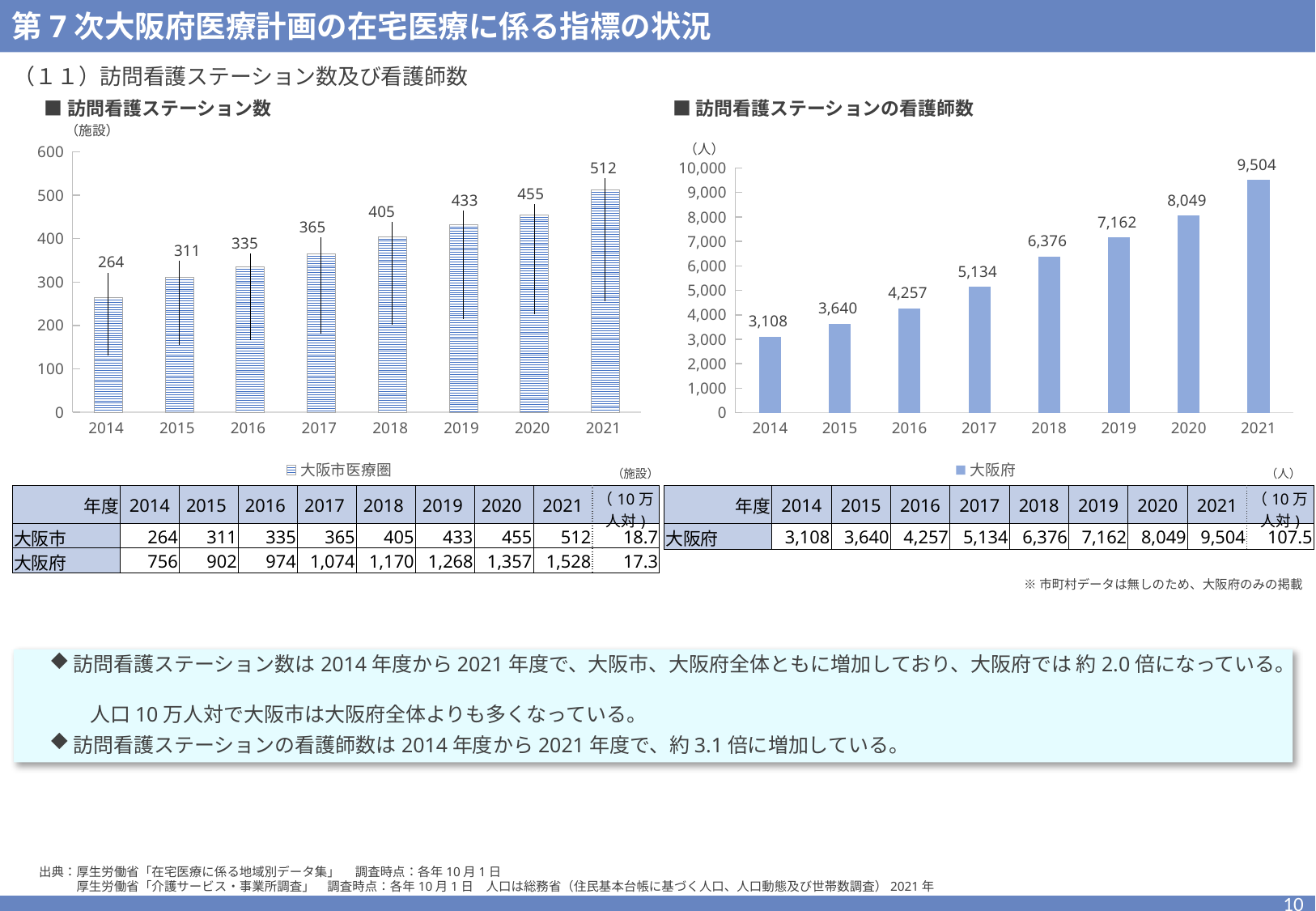
In the 訪問看護ステーション数 chart, how many years are plotted? 8 What kind of chart is the 訪問看護ステーションの看護師数 chart? bar chart In the 訪問看護ステーション数 chart, do the values rise or fall from 2014 to 2021? rise In the 訪問看護ステーションの看護師数 chart, which year has the lowest value? 2014 In the 訪問看護ステーションの看護師数 chart, what is the value for 2017? 5,134 In the 訪問看護ステーション数 chart, which year has the highest value? 2021 What series name does the legend of the 訪問看護ステーション数 chart show? 大阪市医療圏 In the 訪問看護ステーション数 chart, what is the value for 2018? 405 In the 訪問看護ステーション数 chart, what is the value for 2014? 264 In the 訪問看護ステーションの看護師数 chart, what is the value for 2021? 9,504 In the 訪問看護ステーション数 chart, what is the difference between the 2021 and 2014 values? 248 In the 訪問看護ステーションの看護師数 chart, which is larger, the value for 2019 or the value for 2020? 2020